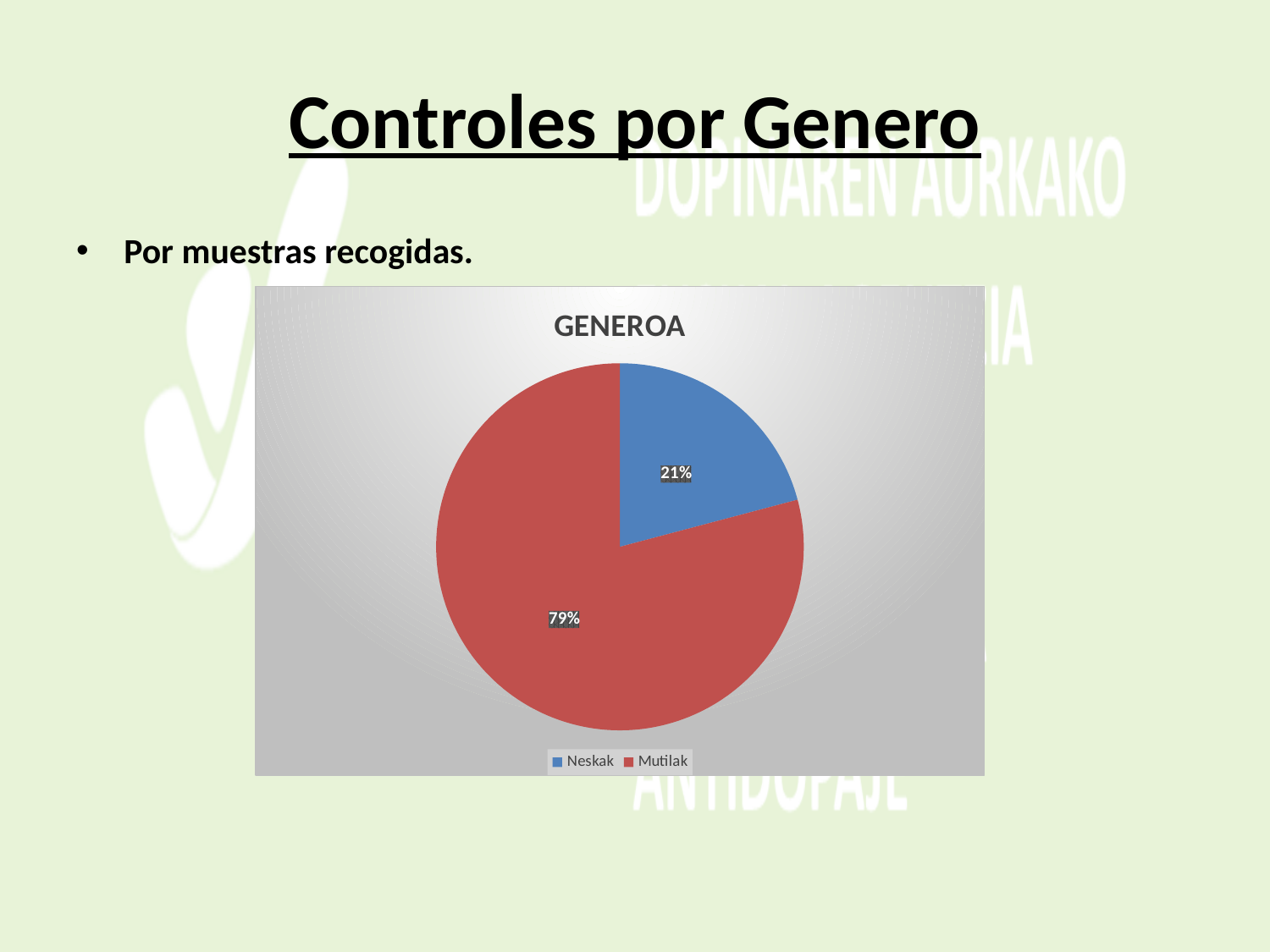
How many entries does the legend list? 2 How many categories does the pie chart show? 2 What kind of chart is shown on the slide? pie chart What share of the pie does Neskak represent? 21% Which category has the largest slice of the pie? Mutilak What share of the pie does Mutilak represent? 79% Which category has the smallest slice of the pie? Neskak What is the title of the chart? GENEROA Which is larger, the Neskak slice or the Mutilak slice? Mutilak What is the difference in percentage points between the Mutilak and Neskak slices? 58 What colour is the Neskak slice? blue